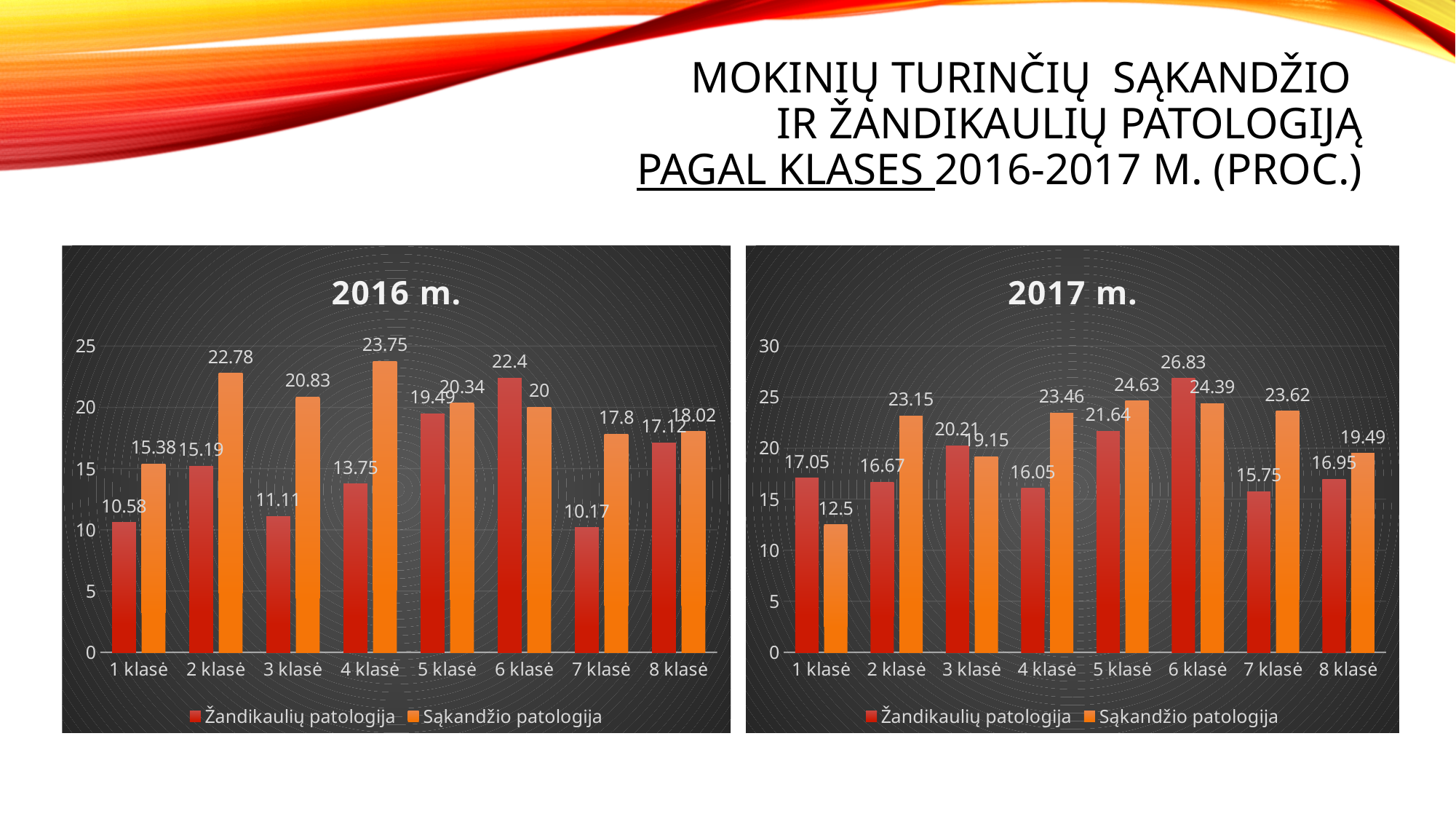
In the "2016 m." chart, what is the difference between Sąkandžio patologija and Žandikaulių patologija for 3 klasė? 9.72 In the "2017 m." chart, which is larger for 1 klasė: Žandikaulių patologija or Sąkandžio patologija? Žandikaulių patologija How many classes are shown on the x axis of the "2016 m." chart? 8 In the "2017 m." chart, what is the value of Sąkandžio patologija for 5 klasė? 24.63 How many series does the legend of the "2017 m." chart list? 2 In the "2016 m." chart, which class has the highest value for Sąkandžio patologija? 4 klasė In the "2016 m." chart, what is the value of Žandikaulių patologija for 4 klasė? 13.75 In the "2017 m." chart, which class has the lowest value for Sąkandžio patologija? 1 klasė What type of chart is the "2016 m." chart? Bar chart In the "2017 m." chart, which class has the highest value for Žandikaulių patologija? 6 klasė In the "2016 m." chart, what is the value of Sąkandžio patologija for 2 klasė? 22.78 In the "2017 m." chart, what is the value of Žandikaulių patologija for 7 klasė? 15.75